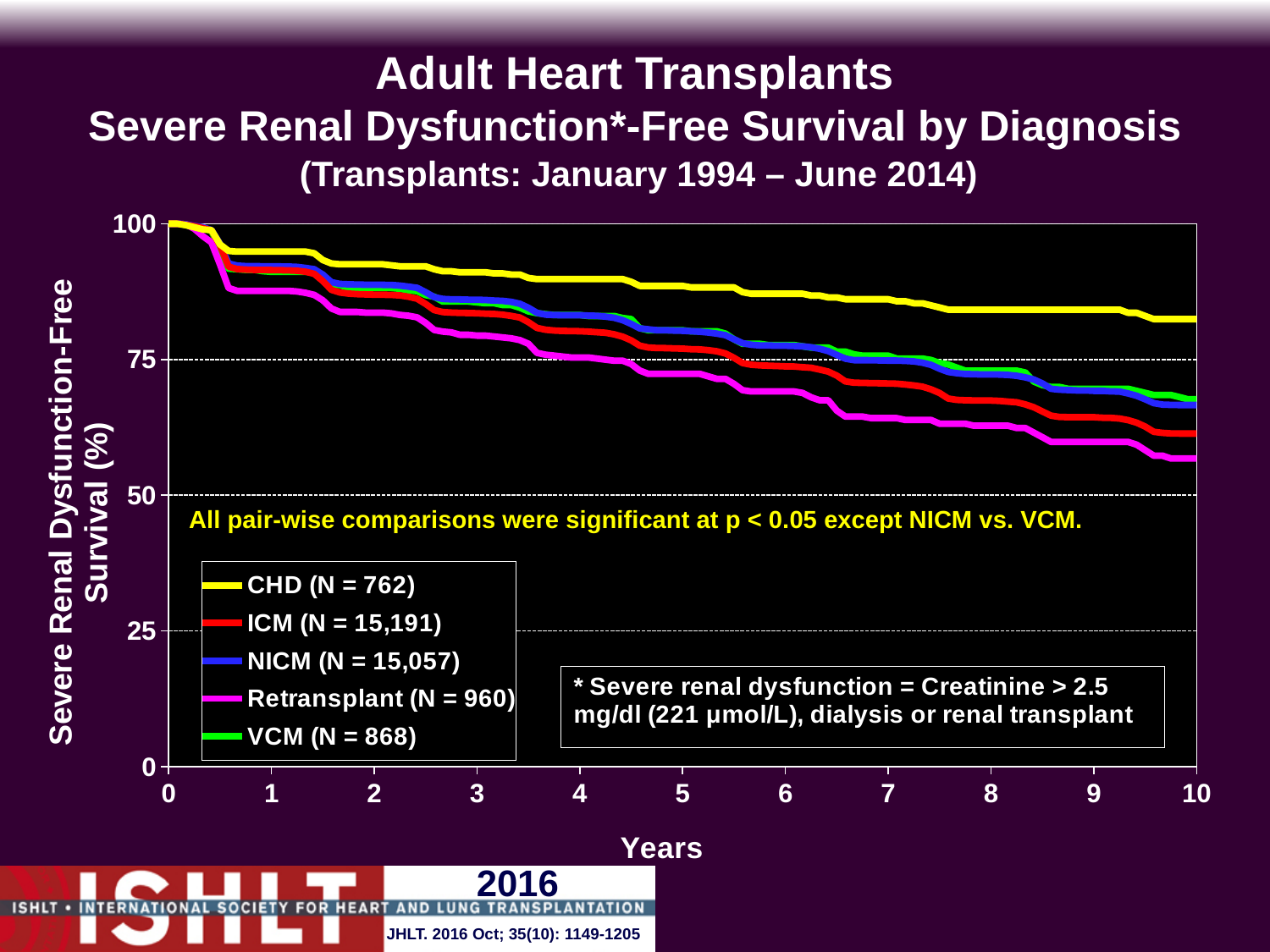
Is the survival value for Retransplant at 10 years greater or less than 75? less Is the survival value for Retransplant at 10 years greater or less than 50? greater Which diagnosis group has the lowest severe renal dysfunction-free survival at 10 years? Retransplant What kind of chart is shown on the slide? line chart Do the survival curves rise or fall as years increase? fall What is the sample size (N) shown in the legend for ICM? 15,191 Which diagnosis group has the highest severe renal dysfunction-free survival at 10 years? CHD At 10 years, which has the higher survival value, CHD or Retransplant? CHD Which colour represents the CHD group in the chart? yellow How many series does the legend list? 5 Is the survival value for CHD at 10 years greater or less than 75? greater